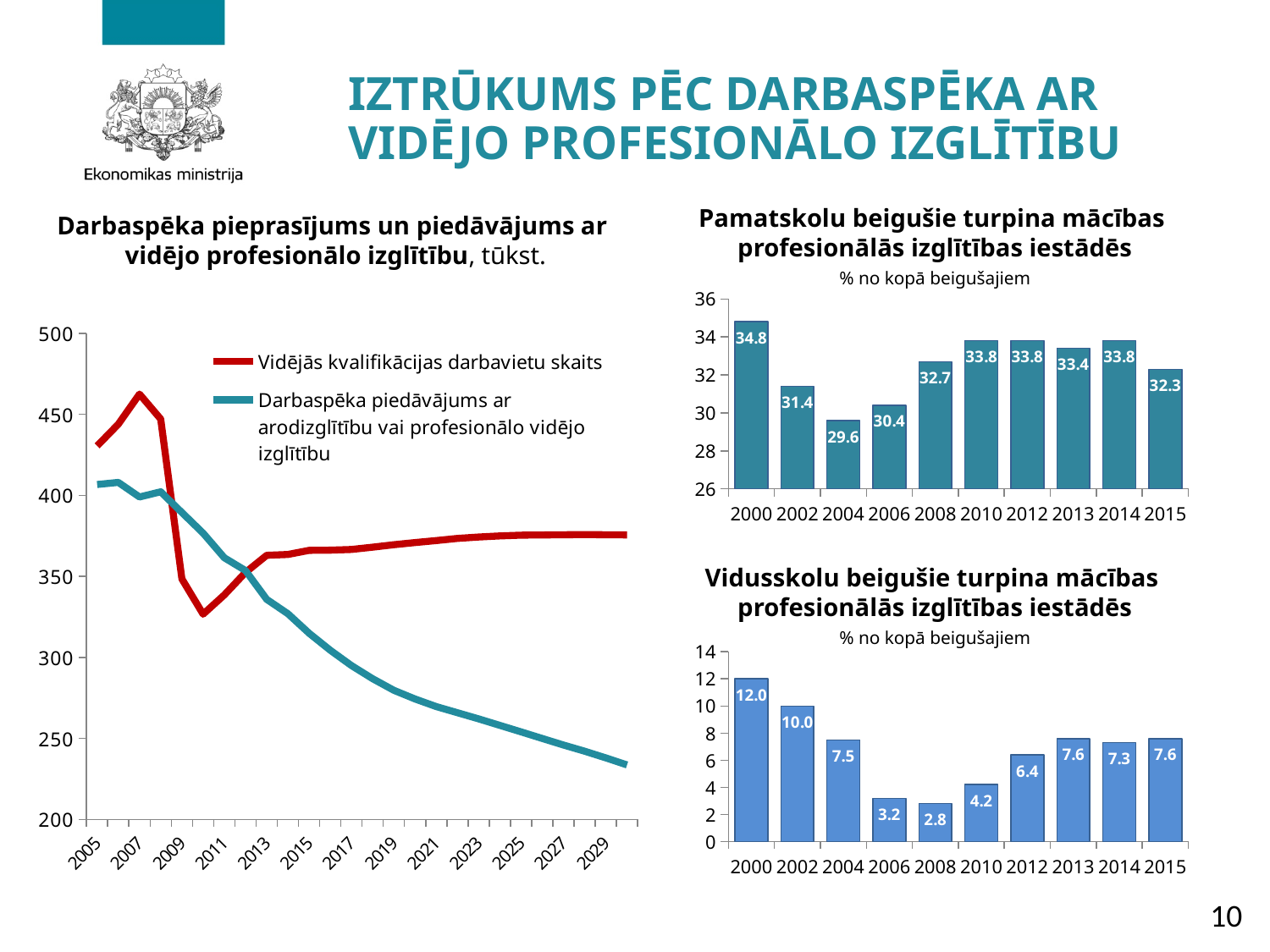
In the chart 'Vidusskolu beigušie turpina mācības profesionālās izglītības iestādēs', which year has the highest value? 2000 In the chart 'Pamatskolu beigušie turpina mācības profesionālās izglītības iestādēs', what is the difference between the values for 2000 and 2015? 2.5 In the chart 'Pamatskolu beigušie turpina mācības profesionālās izglītības iestādēs', what is the value for 2000? 34.8 In the chart 'Pamatskolu beigušie turpina mācības profesionālās izglītības iestādēs', how many years are shown on the x axis? 10 In the chart 'Vidusskolu beigušie turpina mācības profesionālās izglītības iestādēs', what is the value for 2008? 2.8 In the chart 'Pamatskolu beigušie turpina mācības profesionālās izglītības iestādēs', which year has the lowest value? 2004 In the chart 'Vidusskolu beigušie turpina mācības profesionālās izglītības iestādēs', what is the difference between the values for 2000 and 2002? 2.0 In the chart 'Vidusskolu beigušie turpina mācības profesionālās izglītības iestādēs', which is larger, the value for 2012 or the value for 2014? 2014 What kind of chart is 'Vidusskolu beigušie turpina mācības profesionālās izglītības iestādēs'? Bar chart In the line chart 'Darbaspēka pieprasījums un piedāvājums ar vidējo profesionālo izglītību', how many series does the legend list? 2 In the line chart 'Darbaspēka pieprasījums un piedāvājums ar vidējo profesionālo izglītību', does the 'Darbaspēka piedāvājums ar arodizglītību vai profesionālo vidējo izglītību' series rise or fall from 2013 to 2029? fall In the line chart 'Darbaspēka pieprasījums un piedāvājums ar vidējo profesionālo izglītību', is the value of 'Darbaspēka piedāvājums ar arodizglītību vai profesionālo vidējo izglītību' in 2029 greater or less than 250? less